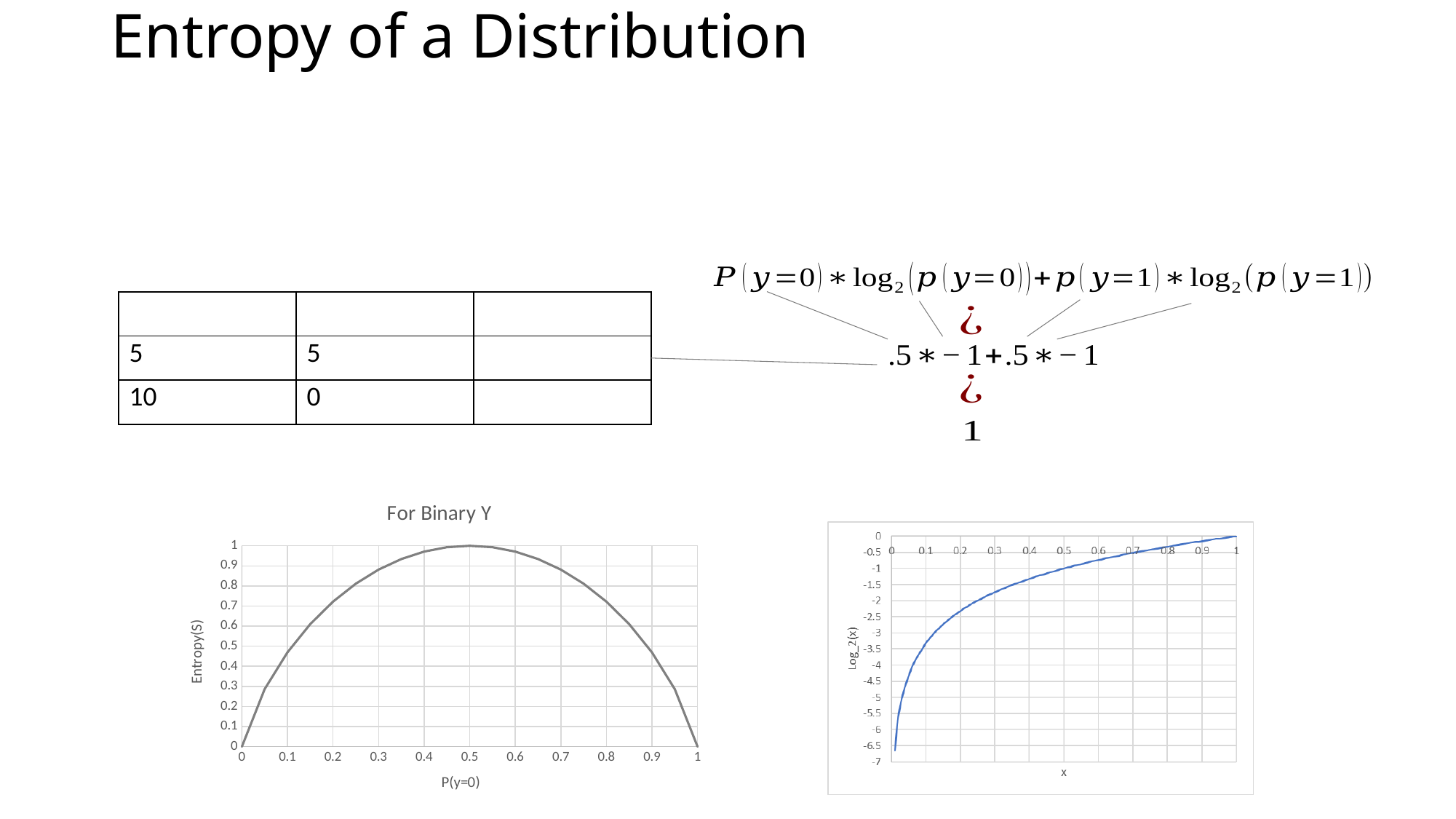
In the 'For Binary Y' chart, is the value of Entropy(S) at P(y=0) = 0.1 greater or less than 0.4? greater In the 'For Binary Y' chart, what is the value of Entropy(S) when P(y=0) is 0.5? 1 What is the y-axis label of the 'For Binary Y' chart? Entropy(S) What kind of chart is the 'For Binary Y' chart? line chart In the 'For Binary Y' chart, at which value of P(y=0) is Entropy(S) highest? 0.5 In the chart on the right (Log_2(x) vs x), what is the value of Log_2(x) when x is 0.5? -1 In the chart on the right (Log_2(x) vs x), does the line rise or fall as x increases? rise In the chart on the right (Log_2(x) vs x), is the value of Log_2(x) at x = 0.1 greater or less than -3? less In the chart on the right (Log_2(x) vs x), what is the value of Log_2(x) when x is 1? 0 In the 'For Binary Y' chart, what is the value of Entropy(S) when P(y=0) is 0? 0 In the 'For Binary Y' chart, is the value of Entropy(S) at P(y=0) = 0.2 greater or less than 0.6? greater In the 'For Binary Y' chart, does Entropy(S) rise or fall as P(y=0) goes from 0.5 to 1? fall